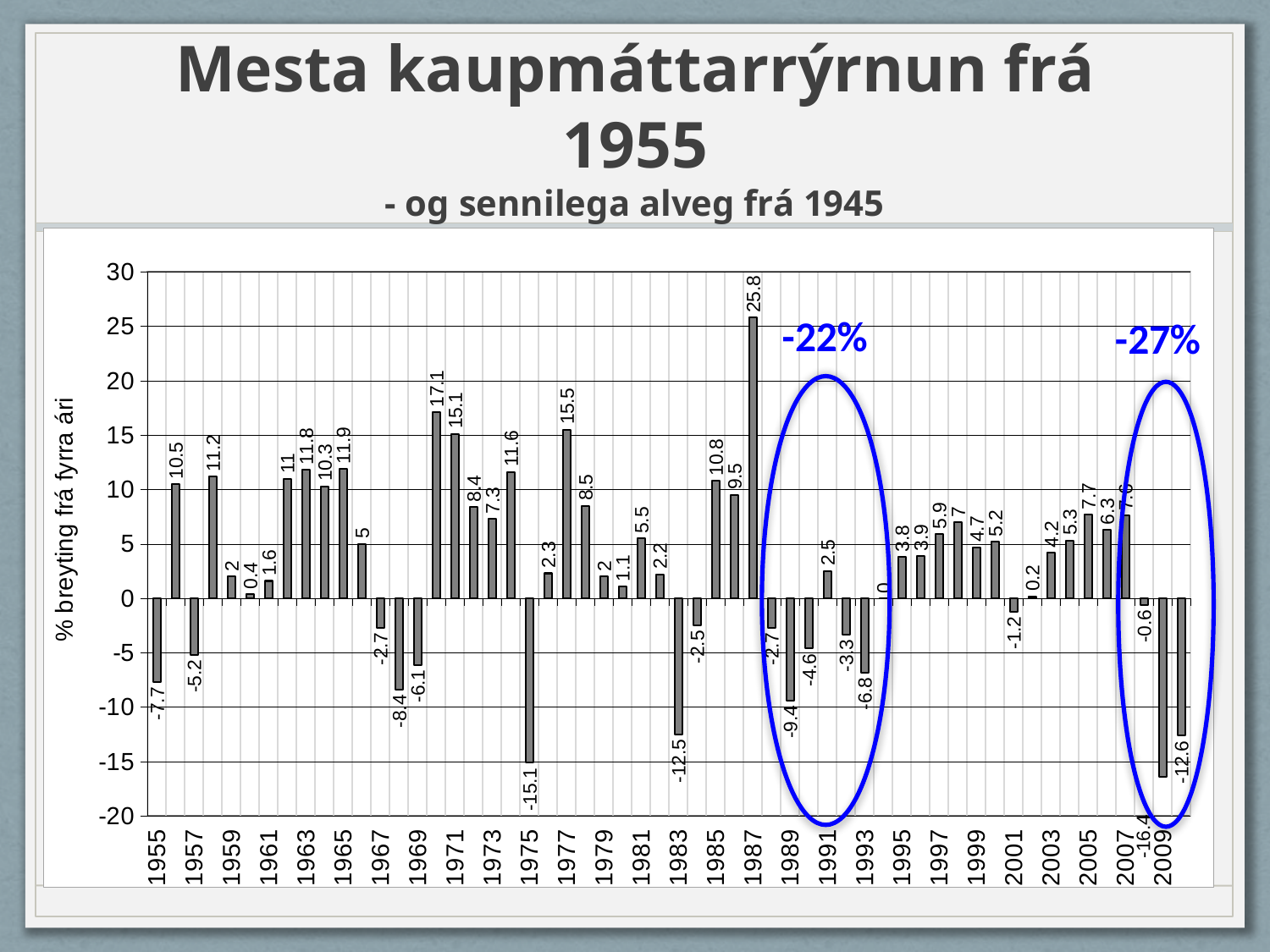
Is the value for 1987 greater or less than 20? greater What is the value for 1975? -15.1 What type of chart is shown on the slide? bar chart Which year has the lowest value? 2009 What is the value for 1955? -7.7 What percentage is written above the right-hand blue circle? -27% Which year has the highest value? 1987 Which is larger, the value for 1977 or the value for 1985? 1977 What is the difference between the values for 1983 and 1975? 2.6 What is the value for 1987? 25.8 What is the label on the vertical axis? % breyting frá fyrra ári What is the value for 2009? -16.4